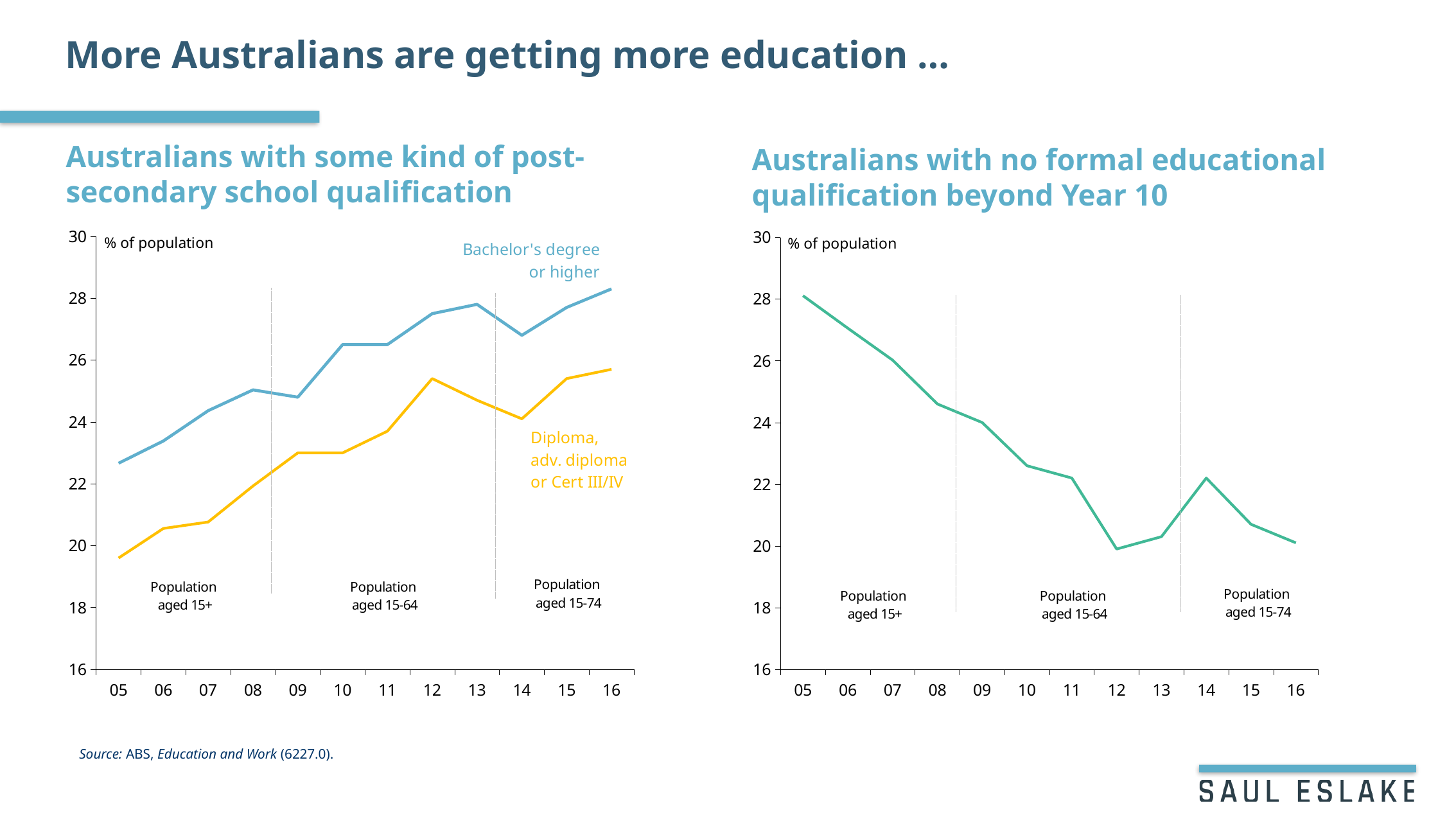
On the left chart, is the value for 'Diploma, adv. diploma or Cert III/IV' in 16 greater or less than 26? less How many series are plotted on the left chart, 'Australians with some kind of post-secondary school qualification'? 2 On the left chart, which series is higher in 10: 'Bachelor's degree or higher' or 'Diploma, adv. diploma or Cert III/IV'? Bachelor's degree or higher On the left chart, is the value for 'Bachelor's degree or higher' in 05 greater or less than 22? greater On the right chart, 'Australians with no formal educational qualification beyond Year 10', is the value for 10 greater or less than 24? less On the left chart, in which year is the 'Bachelor's degree or higher' series at its lowest? 05 On the right chart, 'Australians with no formal educational qualification beyond Year 10', in which year is the value highest? 05 What kind of chart is the chart titled 'Australians with some kind of post-secondary school qualification'? line chart What unit is shown on the y axis of the left chart? % of population On the right chart, 'Australians with no formal educational qualification beyond Year 10', do the values generally rise or fall from 05 to 16? fall How many years are shown on the x axis of the right chart, 'Australians with no formal educational qualification beyond Year 10'? 12